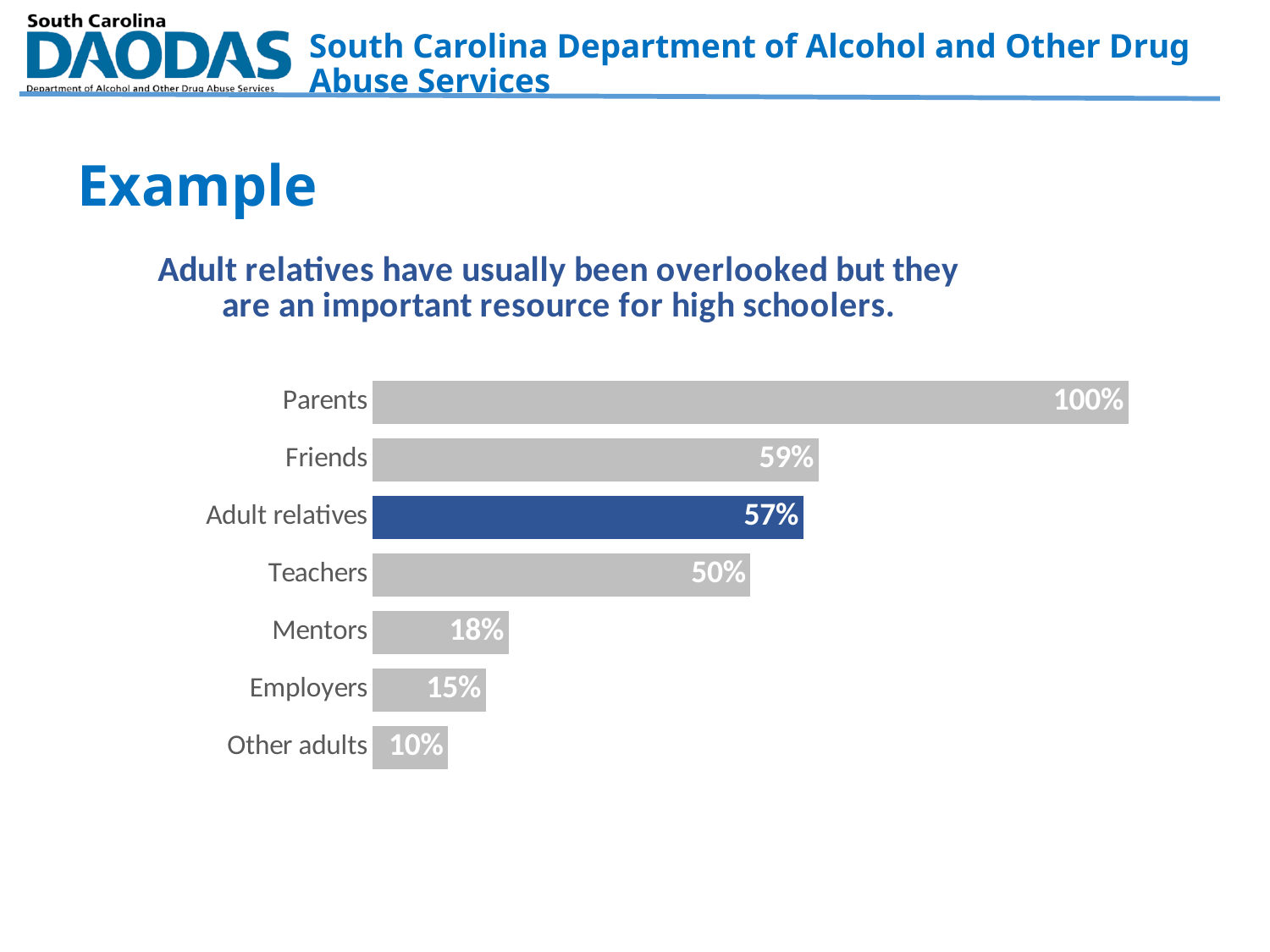
What is the value for Employers? 15% Which category has the highest value? Parents What is the value for Teachers? 50% Which category has the lowest value? Other adults What is the difference between the values for Parents and Teachers? 50% Which category's bar is highlighted in blue rather than grey? Adult relatives What is the difference between the values for Friends and Adult relatives? 2% What is the value for Mentors? 18% What is the value for Adult relatives? 57% How many categories are shown in the chart? 7 Which is larger, the value for Mentors or the value for Employers? Mentors What kind of chart is shown on the slide? Bar chart